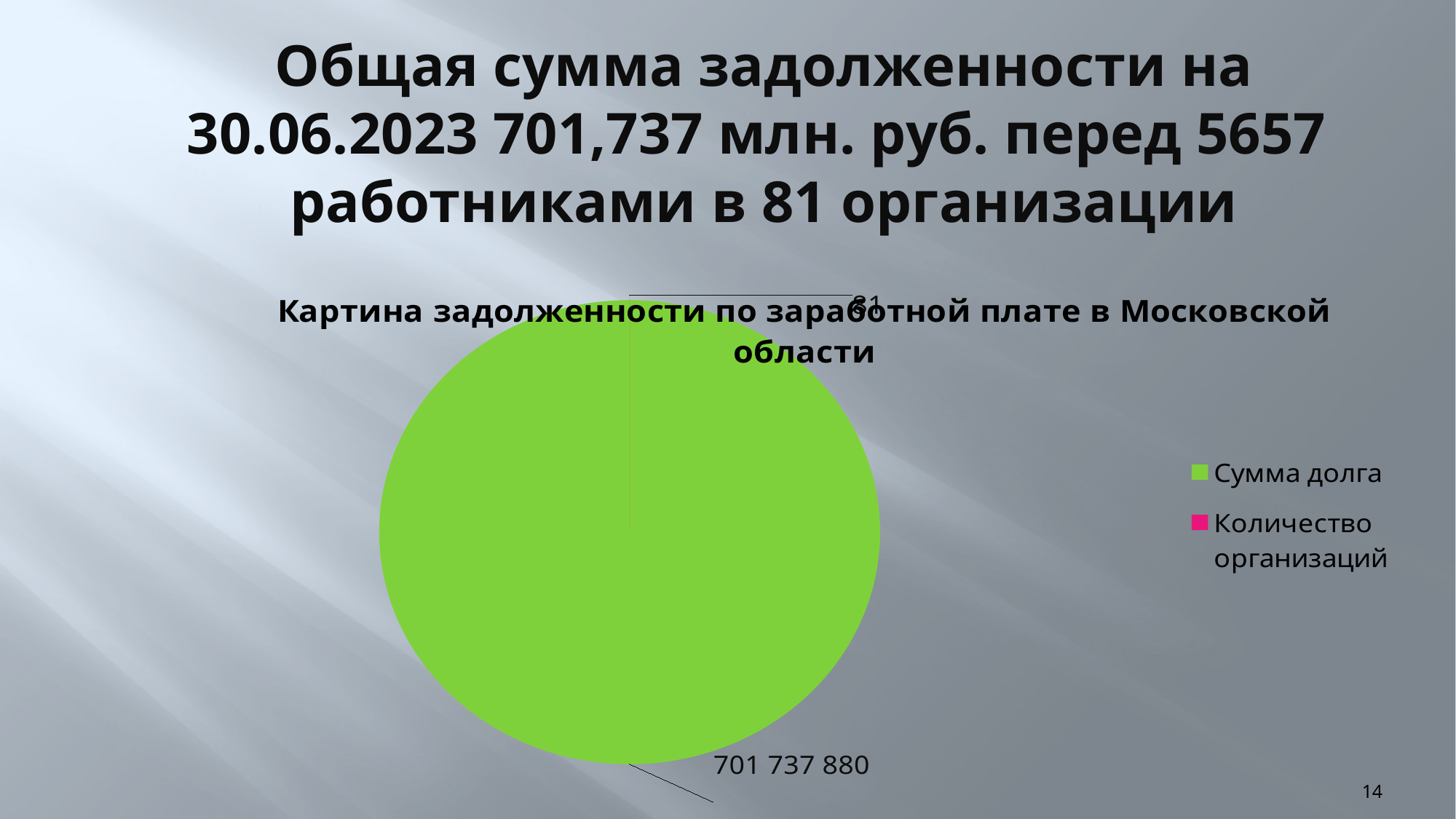
What is the value shown for Количество организаций in the pie chart? 81 Which category takes up the largest share of the pie chart? Сумма долга What colour represents Сумма долга in the pie chart? green What kind of chart is shown on the slide? pie chart How many entries does the chart legend list? 2 Which category takes up the smallest share of the pie chart? Количество организаций What is the value shown for Сумма долга in the pie chart? 701 737 880 What is the title of the pie chart? Картина задолженности по заработной плате в Московской области Which is larger, the value for Сумма долга or the value for Количество организаций? Сумма долга